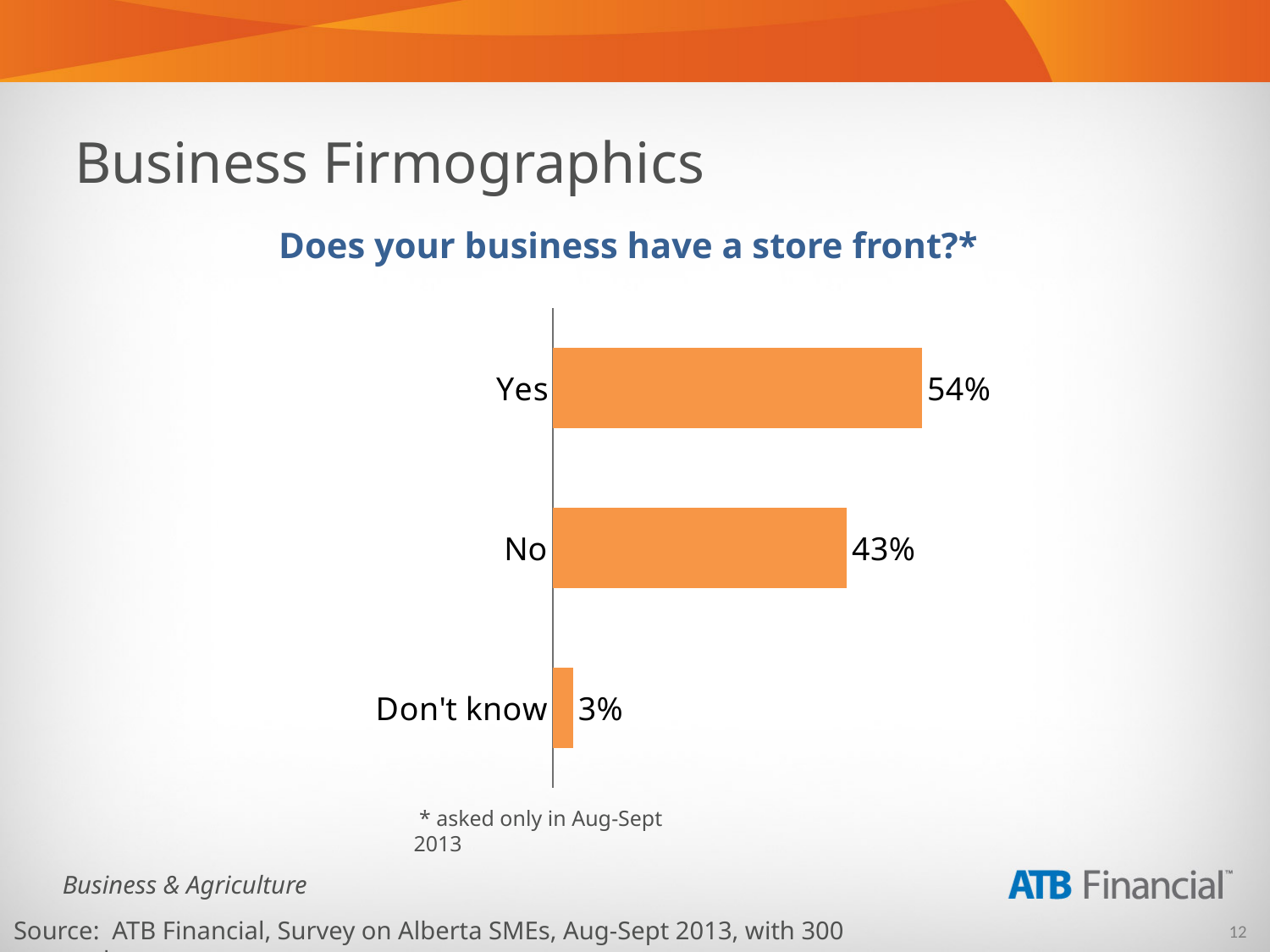
What is the difference in percentage points between the "Yes" and "No" responses? 11 Which response category has the lowest value? Don't know Which response category has the highest value? Yes What percentage of businesses answered "No" to having a store front? 43% What colour are the bars in the chart? Orange How many response categories are shown in the chart? 3 Which is larger, the value for "Yes" or the value for "No"? Yes What kind of chart is shown on the slide? Bar chart What percentage of businesses answered "Don't know"? 3% What is the difference in percentage points between the "No" and "Don't know" responses? 40 What percentage of businesses answered "Yes" to having a store front? 54% What is the title of the chart? Does your business have a store front?*